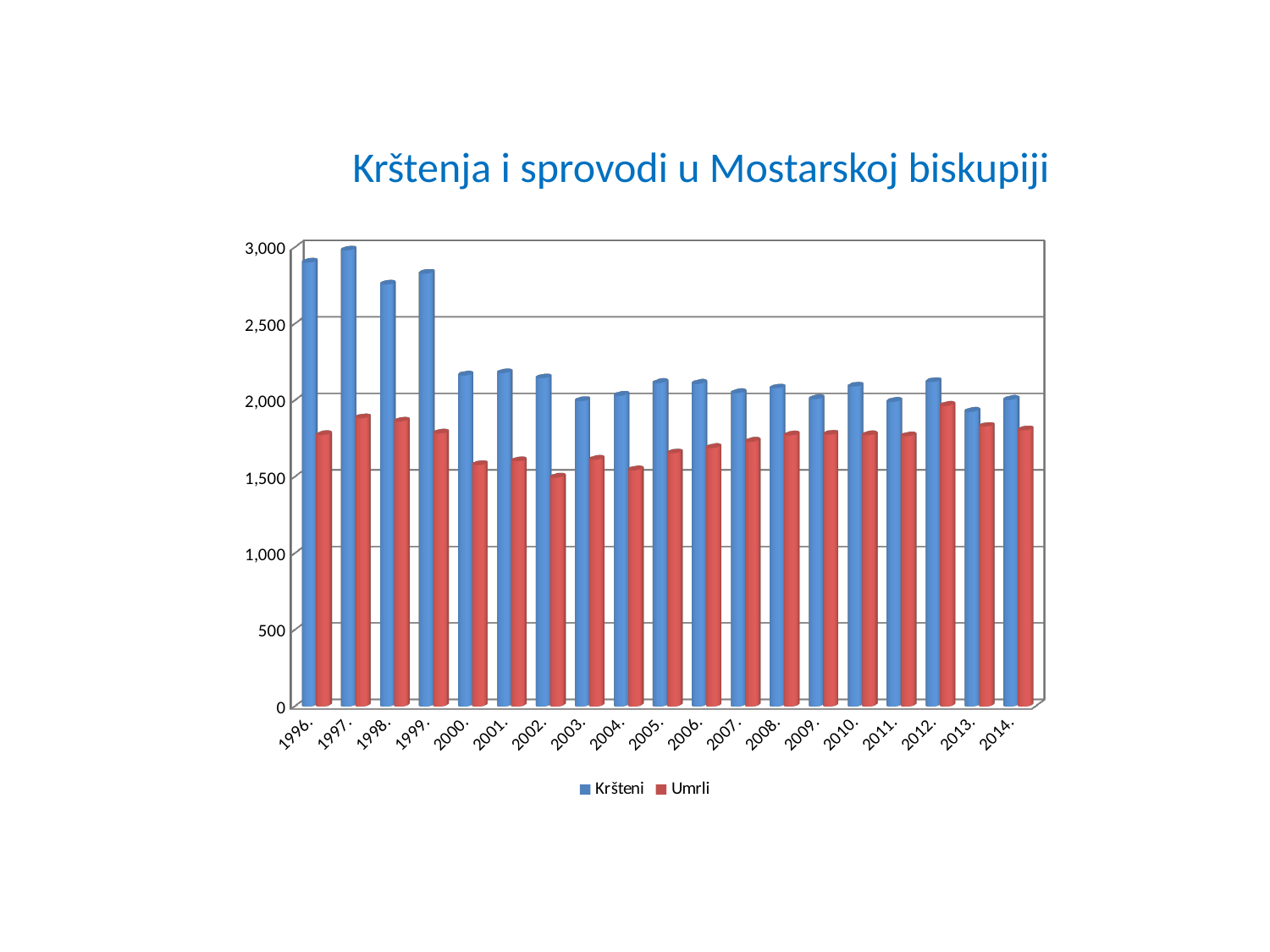
In which year is the Kršteni value highest? 1997. In which year is the Umrli value highest? 2012. Is the Kršteni value for 1997. greater or less than 2,500? greater How many series does the legend list? 2 What type of chart is shown on the slide? bar chart In 1996., which is larger, Kršteni or Umrli? Kršteni Is the Umrli value for 1996. greater or less than 1,500? greater Do the Kršteni values overall rise or fall from 1996. to 2014.? fall In which year is the Umrli value lowest? 2002. Is the Kršteni value for 2000. greater or less than 2,000? greater How many years are shown on the x axis? 19